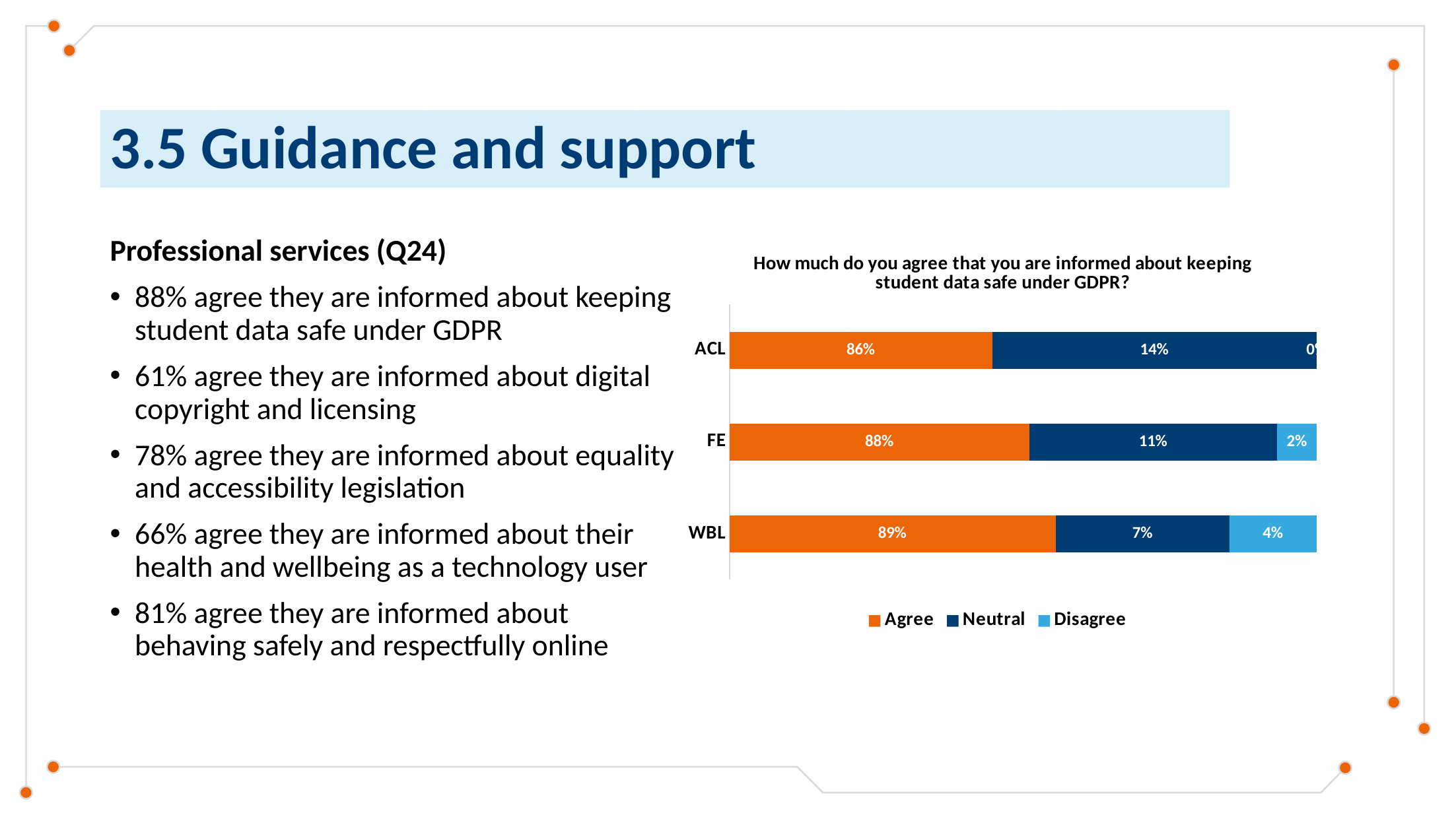
Which category has the lowest Neutral percentage? WBL How many series does the chart legend list? 3 Which category has the highest Agree percentage? WBL What is the Neutral value for FE in the chart? 11% What is the Disagree value for WBL in the chart? 4% What percentage of ACL respondents agree that they are informed about keeping student data safe under GDPR? 86% How many categories are shown on the chart's vertical axis? 3 Which is larger, the Agree value for FE or the Agree value for ACL? FE What type of chart is shown on the slide? Stacked bar chart What is the Agree value for WBL? 89% Which series is shown in orange in the chart? Agree What is the difference between the Neutral values for ACL and WBL? 7%